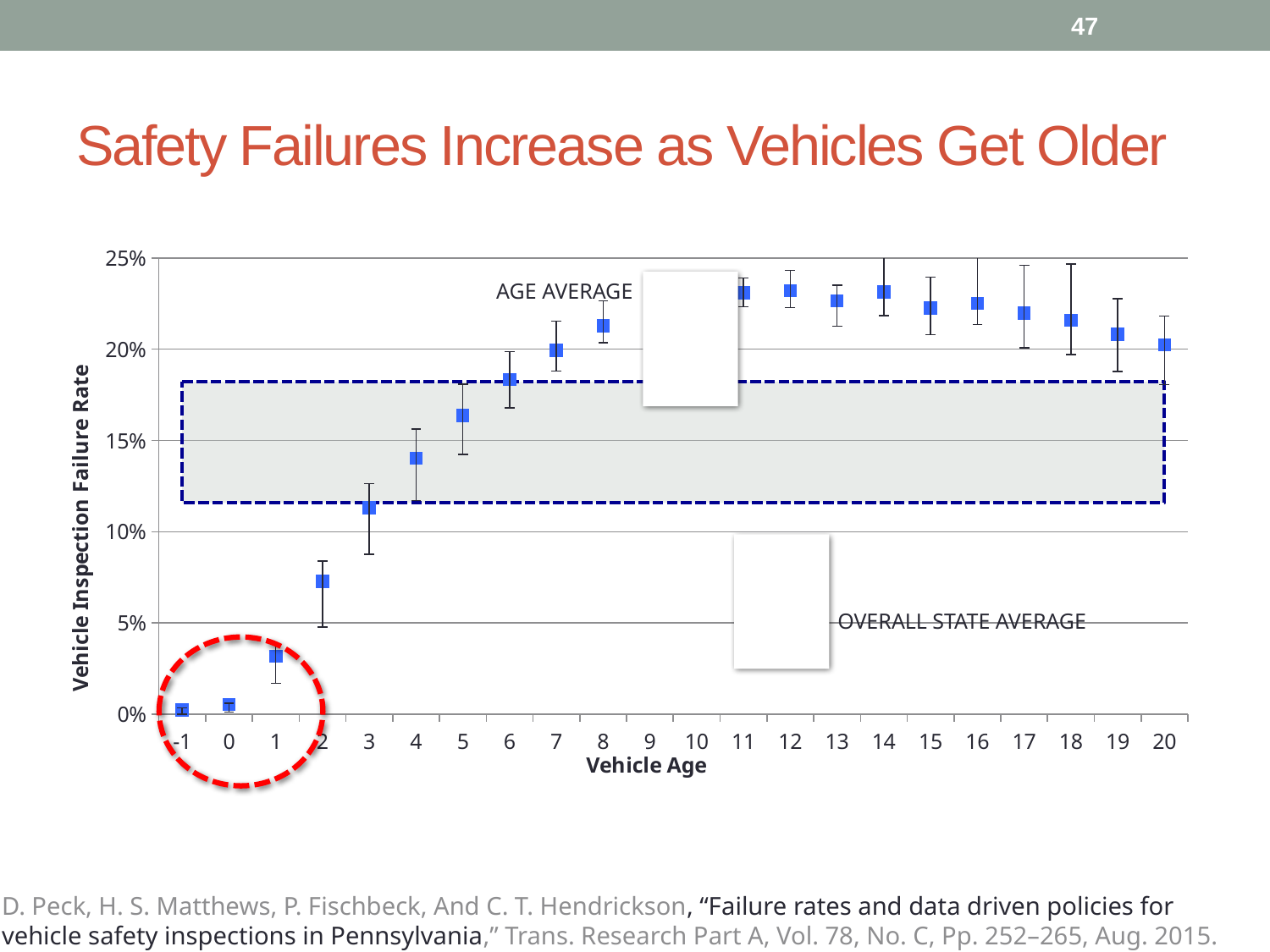
Is the failure rate for vehicle age 2 greater or less than 5%? greater Is the failure rate for vehicle age 6 greater or less than 20%? less What is the title of the slide above the chart? Safety Failures Increase as Vehicles Get Older Is the failure rate for vehicle age 1 greater or less than 5%? less What is the label on the vertical axis of the chart? Vehicle Inspection Failure Rate Which has the higher failure rate, vehicle age 2 or vehicle age 3? Vehicle age 3 Does the failure rate rise or fall as vehicle age increases from -1 to 8? Rises Which has the higher failure rate, vehicle age 1 or vehicle age 8? Vehicle age 8 What kind of chart is shown on the slide? Scatter (point) chart with error bars